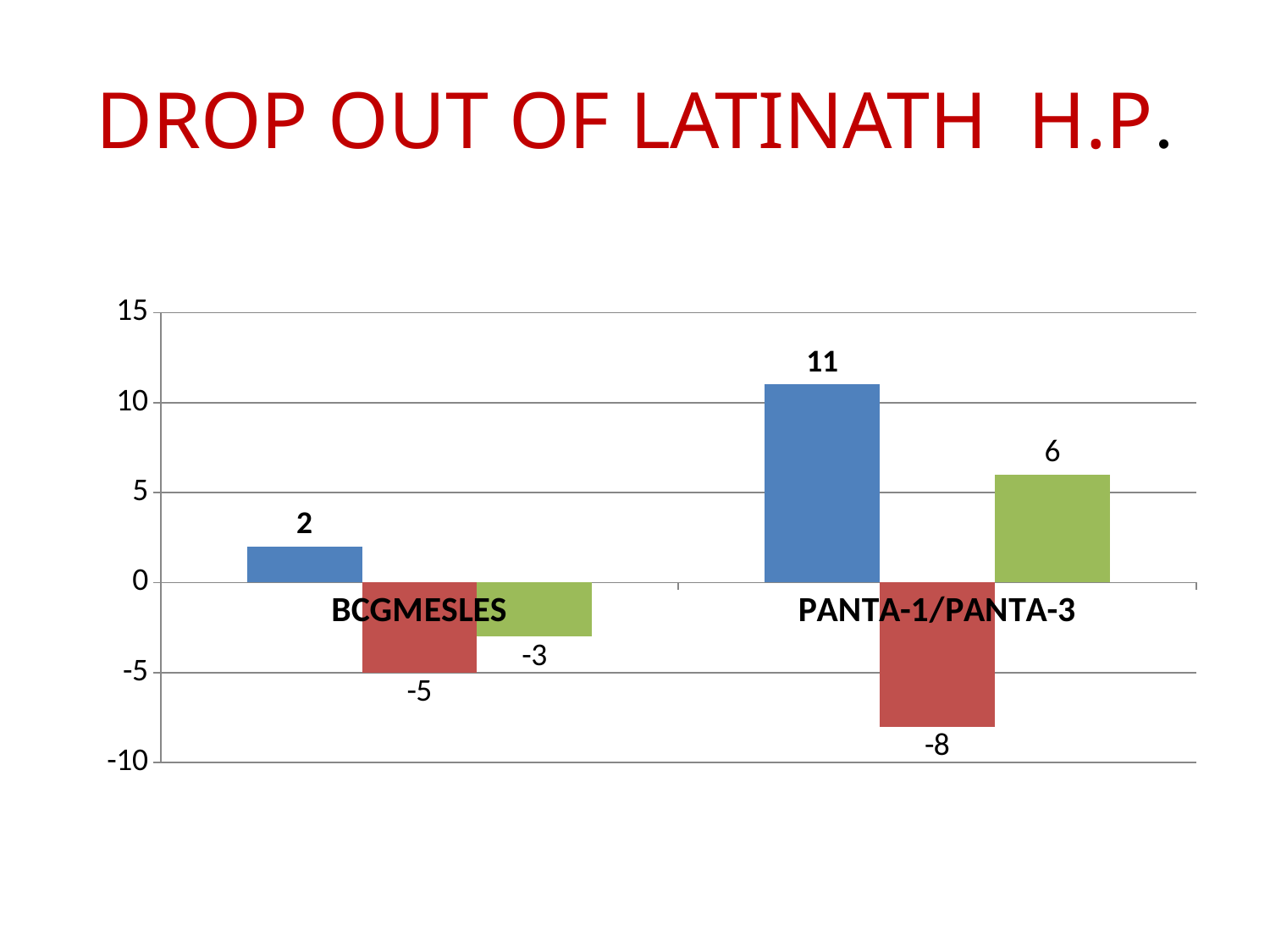
What kind of chart is shown on the slide? Bar chart Which bar has the highest value on the chart? The blue bar for PANTA-1/PANTA-3 What is the value of the green bar for PANTA-1/PANTA-3? 6 What is the value of the blue bar for PANTA-1/PANTA-3? 11 What is the value of the green bar for BCGMESLES? -3 What is the difference between the blue bar values for PANTA-1/PANTA-3 and BCGMESLES? 9 Which bar has the lowest value on the chart? The red bar for PANTA-1/PANTA-3 How many categories are shown on the x axis? 2 Which is larger, the green bar for PANTA-1/PANTA-3 or the blue bar for BCGMESLES? The green bar for PANTA-1/PANTA-3 What is the value of the red bar for BCGMESLES? -5 What is the title of the slide? DROP OUT OF LATINATH H.P. What is the value of the blue bar for BCGMESLES? 2